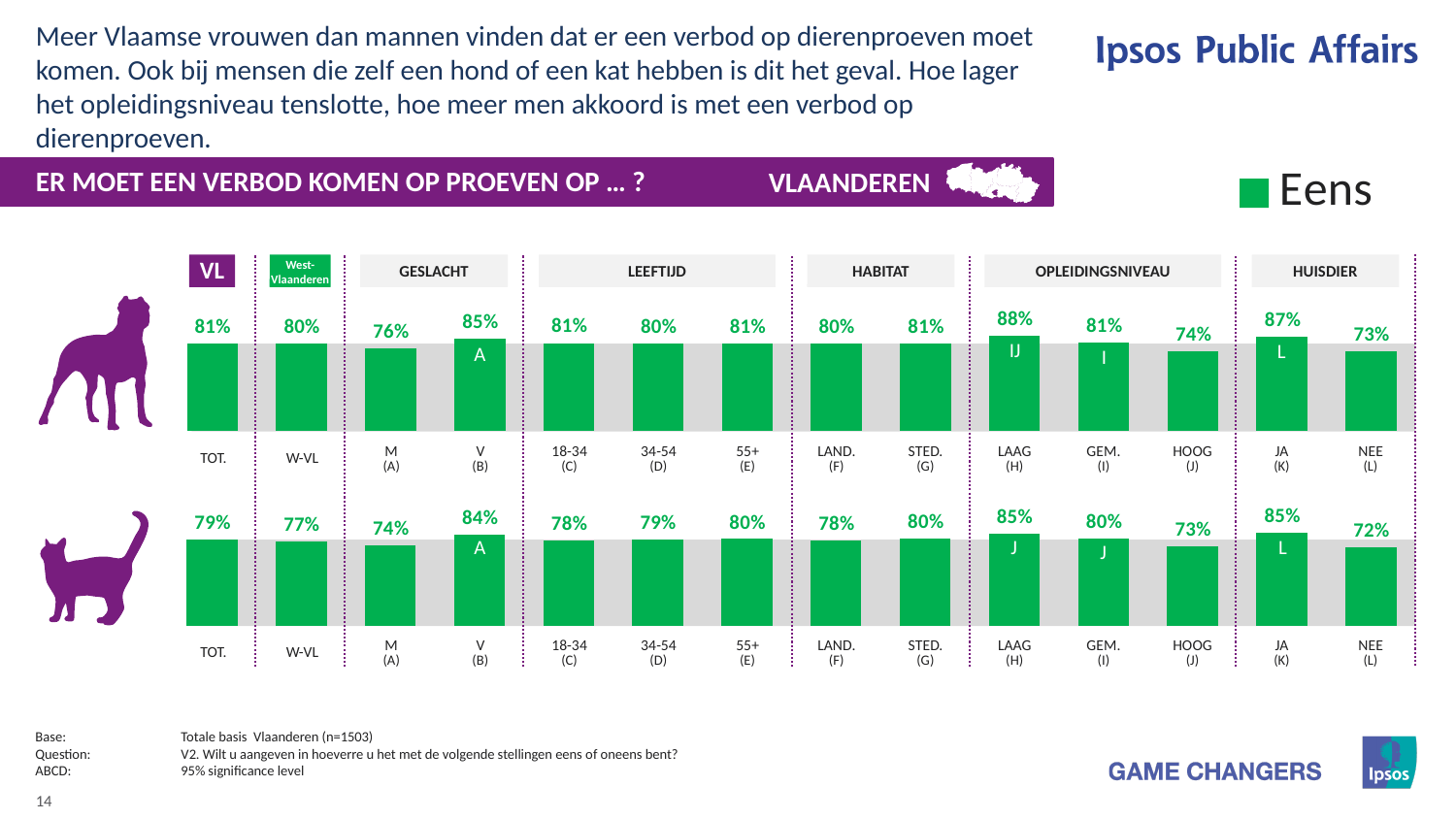
In the bottom chart (cat row), which is larger: the value for TOT. or W-VL? TOT. What kind of chart is used in the bottom row (cat row)? Bar chart In the bottom chart (cat row), which category has the lowest value? NEE (L) In the top chart (dog row), what is the value for TOT.? 81% In the bottom chart (cat row), what is the difference between the values for JA (K) and NEE (L)? 13% In the top chart (dog row), which is larger: the value for LAAG (H) or HOOG (J)? LAAG (H) How many bars are shown in the top chart (dog row)? 14 In the top chart (dog row), do the values rise or fall across the OPLEIDINGSNIVEAU categories from LAAG to HOOG? Fall In the top chart (dog row), which category has the highest value? LAAG (H) In the top chart (dog row), what is the difference between the values for V (B) and M (A)? 9% What is the legend entry shown at the top right of the slide? Eens In the bottom chart (cat row), what is the value for V (B) under GESLACHT? 84%